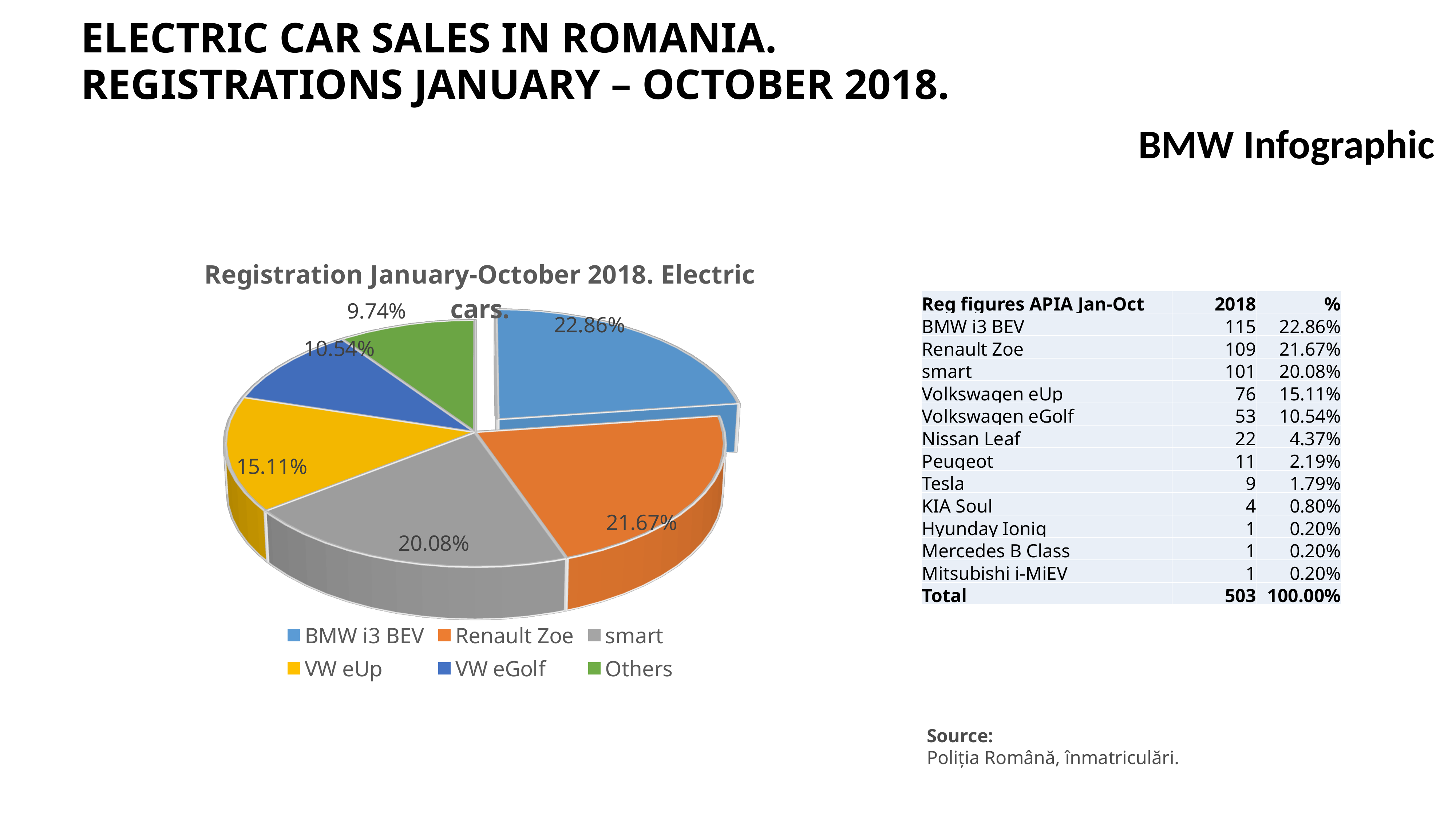
Which slice of the pie chart is the largest? BMW i3 BEV Which slice of the pie chart is the smallest? Others What is the value shown for VW eGolf? 10.54% What share does VW eUp have in the pie chart? 15.11% What share of the pie does BMW i3 BEV hold? 22.86% What percentage is labelled for the Others slice? 9.74% What is the difference in percentage points between the BMW i3 BEV slice and the Renault Zoe slice? 1.19 What kind of chart is shown on the slide? pie chart What is the title of the pie chart? Registration January-October 2018. Electric cars. What is the data label for the Renault Zoe slice? 21.67% How many slices does the pie chart have? 6 What percentage is shown for the smart slice? 20.08%